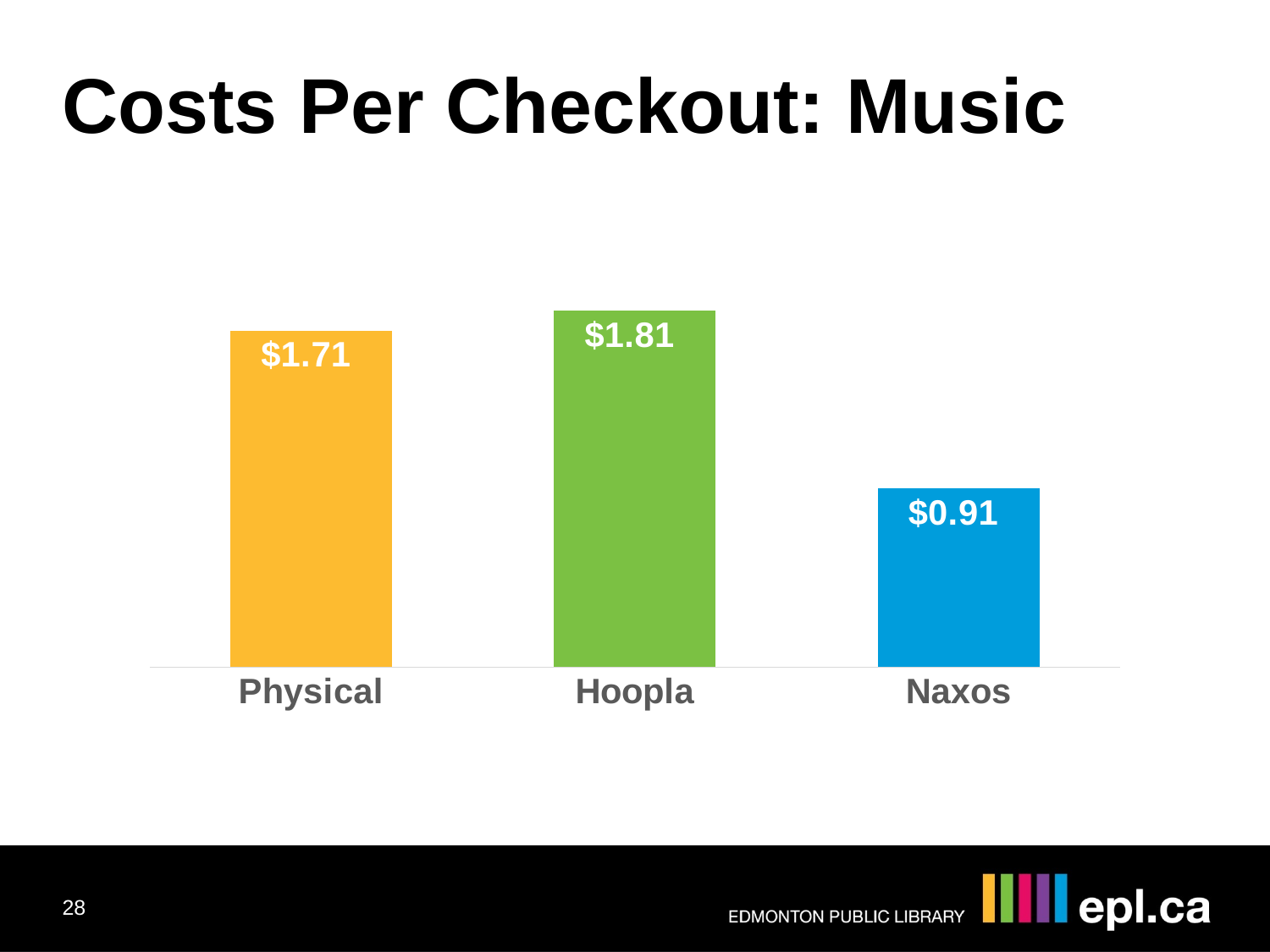
What is the difference in cost per checkout between Hoopla and Physical? $0.10 Which has a higher cost per checkout, Physical or Naxos? Physical What is the cost per checkout for Physical music? $1.71 What is the difference in cost per checkout between Physical and Naxos? $0.80 What kind of chart is shown on the slide? Bar chart How many categories are shown in the chart? 3 What is the cost per checkout for Naxos? $0.91 Which category has the lowest cost per checkout? Naxos What is the title of the slide? Costs Per Checkout: Music What is the cost per checkout for Hoopla? $1.81 Which category has the highest cost per checkout? Hoopla What colour is the bar for Naxos? Blue